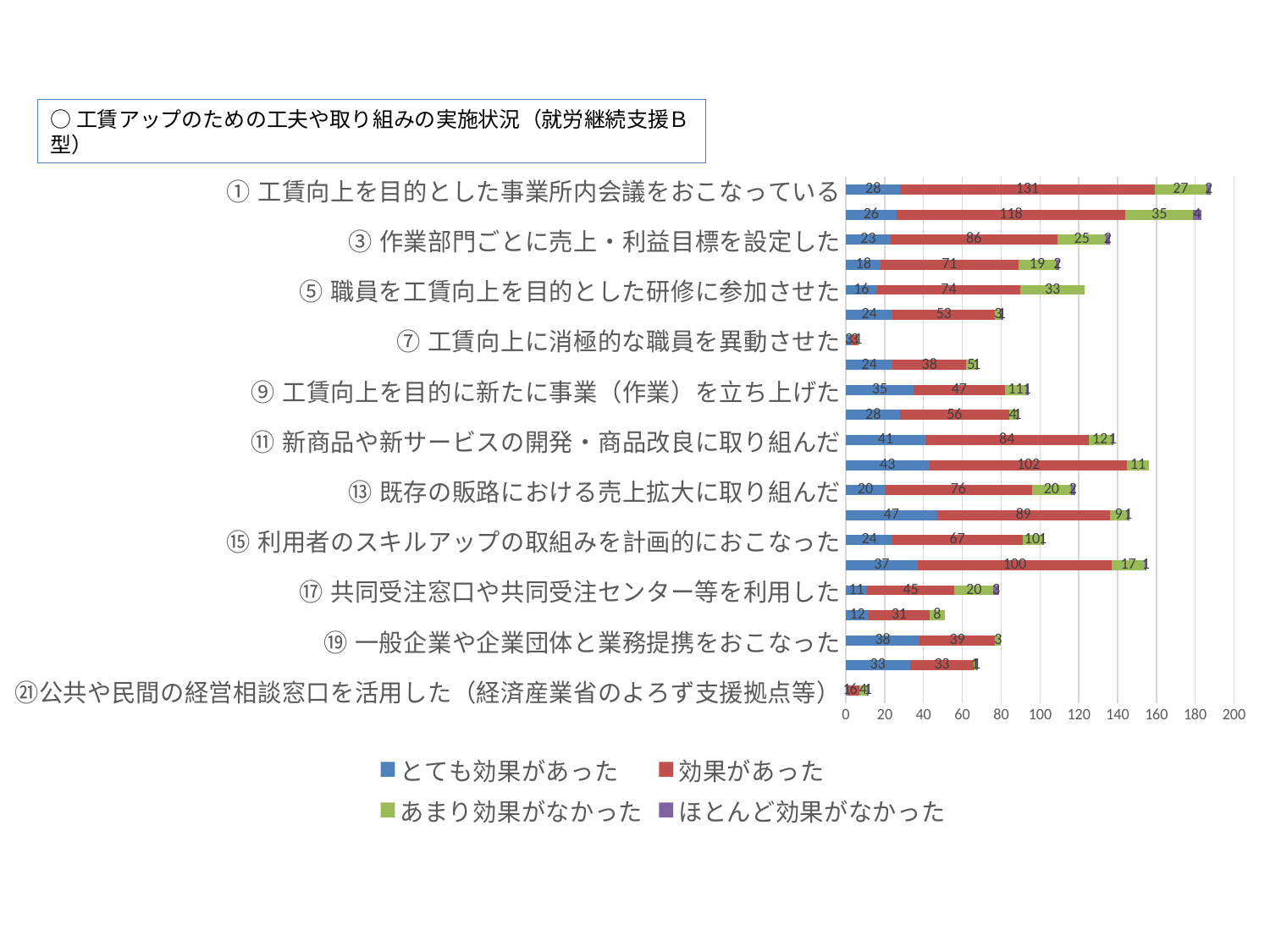
Which has the larger 効果があった value: ① 工賃向上を目的とした事業所内会議をおこなっている or ③ 作業部門ごとに売上・利益目標を設定した? ① 工賃向上を目的とした事業所内会議をおこなっている Which category has the highest 効果があった value? ① 工賃向上を目的とした事業所内会議をおこなっている What is the value of 効果があった for ① 工賃向上を目的とした事業所内会議をおこなっている? 131 Is the total bar length for ⑲ 一般企業や企業団体と業務提携をおこなった greater or less than 100? less How many bars (categories) are plotted in the chart? 21 What is the value of 効果があった for ⑮ 利用者のスキルアップの取組みを計画的におこなった? 67 What is the difference between the 効果があった values for ① 工賃向上を目的とした事業所内会議をおこなっている (131) and ③ 作業部門ごとに売上・利益目標を設定した (86)? 45 What is the value of とても効果があった for ③ 作業部門ごとに売上・利益目標を設定した? 23 What kind of chart is shown on the slide? Stacked bar chart What is the total of the stacked bar for ③ 作業部門ごとに売上・利益目標を設定した (23 + 86 + 25 + 2)? 136 How many series does the legend list? 4 What is the value of あまり効果がなかった for ⑤ 職員を工賃向上を目的とした研修に参加させた? 33